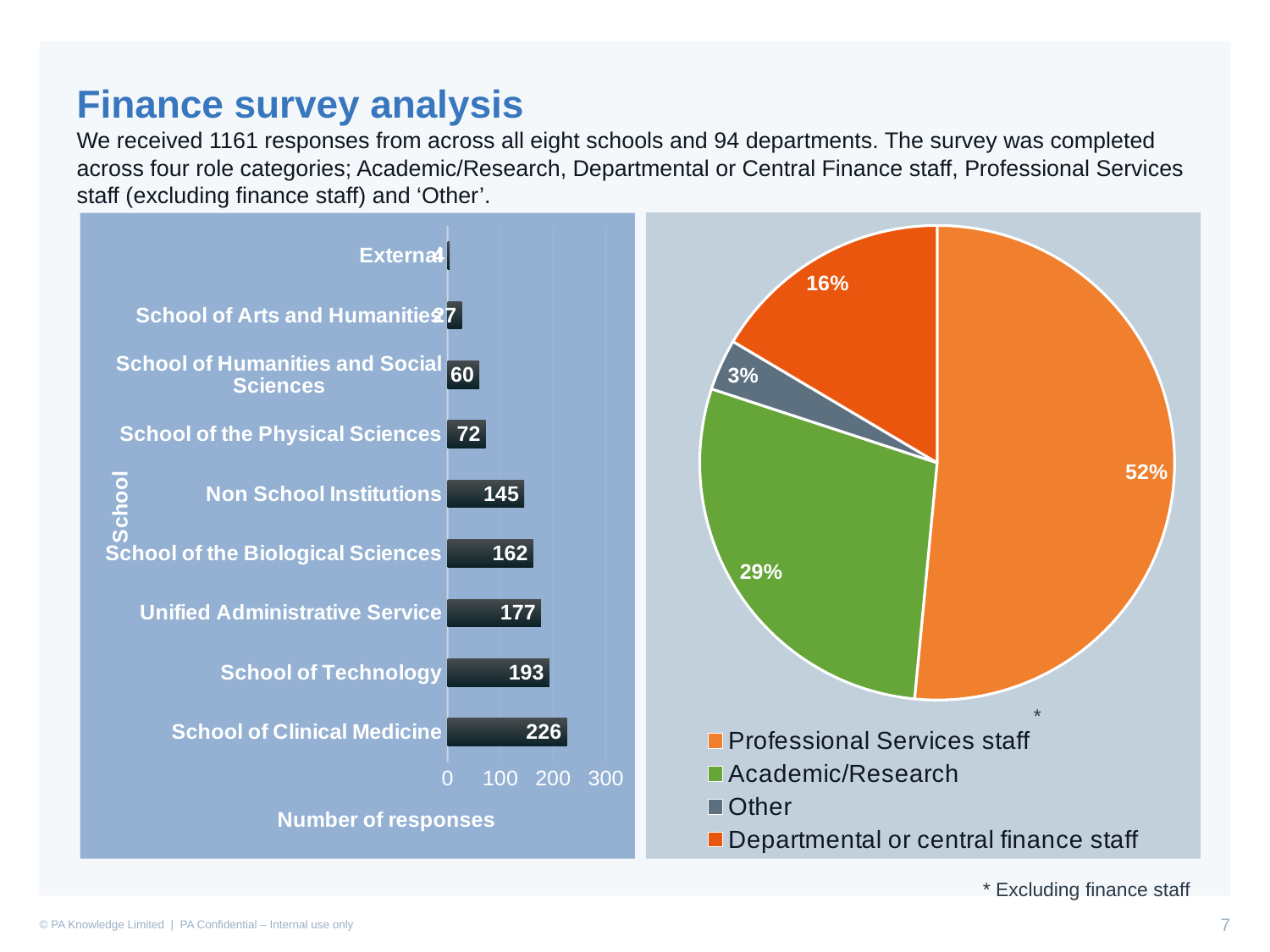
In the bar chart on the left, which has more responses: the School of the Physical Sciences or the School of Humanities and Social Sciences? School of the Physical Sciences In the pie chart on the right, which category has the smallest slice? Other What type of chart is shown on the left of the slide? Bar chart In the bar chart on the left, what is the number of responses for Non School Institutions? 145 In the bar chart on the left, how many responses did the School of Clinical Medicine give? 226 In the pie chart on the right, what share of responses came from Professional Services staff? 52% In the bar chart on the left, how many categories are shown on the School axis? 9 In the bar chart on the left, which school has the highest number of responses? School of Clinical Medicine How many entries does the legend of the pie chart on the right list? 4 In the bar chart on the left, what is the number of responses for the School of Technology? 193 In the bar chart on the left, what is the difference in responses between the Unified Administrative Service and the School of the Biological Sciences? 15 In the pie chart on the right, what percentage is shown for Academic/Research? 29%